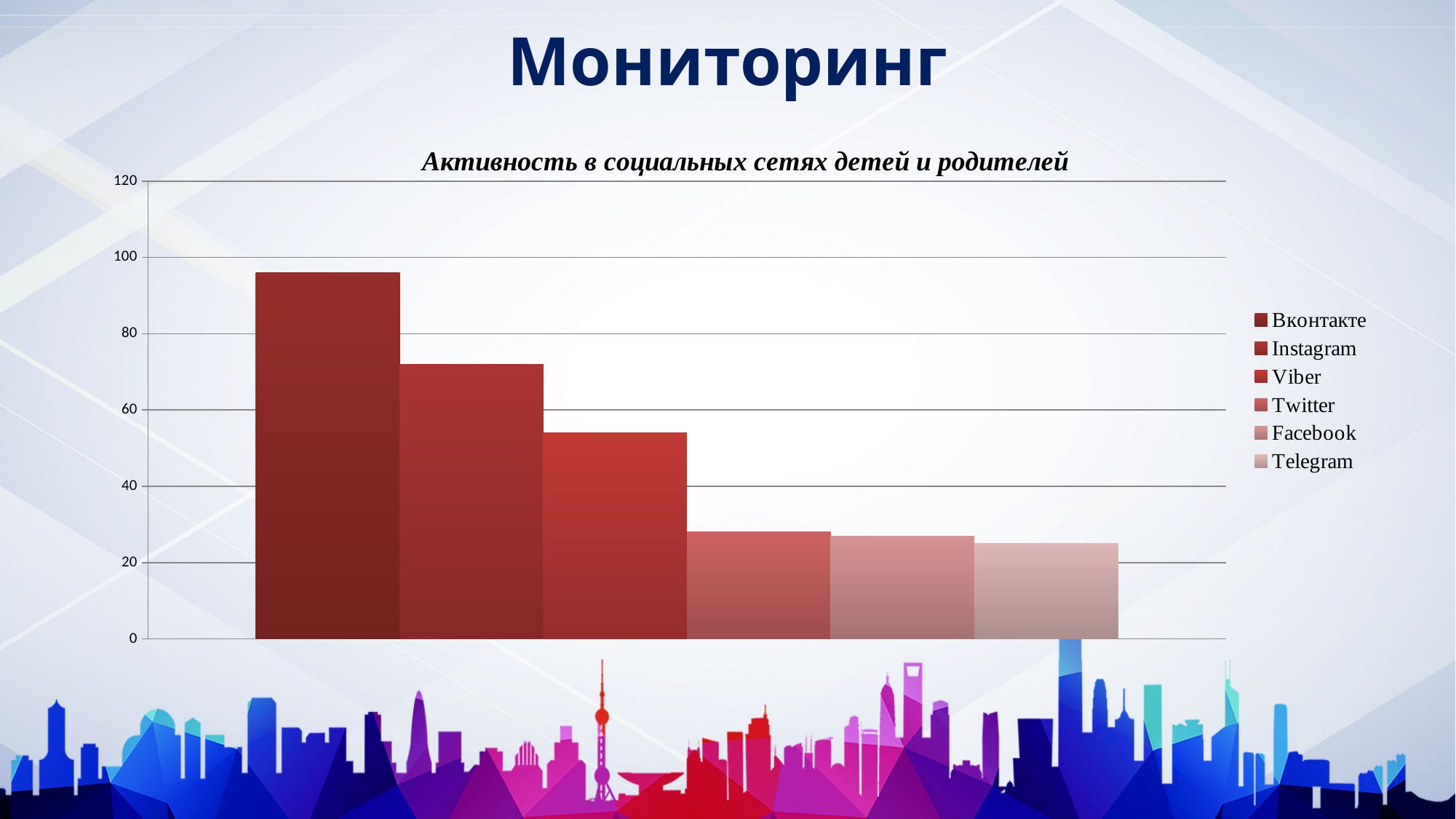
Which social network has the highest value in the chart? Вконтакте Is the value for Twitter greater or less than 40? less Do the bar values rise or fall from left to right across the chart? fall Is the value for Telegram greater or less than 20? greater What is the title of the chart? Активность в социальных сетях детей и родителей Is the value for Instagram greater or less than 60? greater How many series does the legend list? 6 What kind of chart is shown on the slide? bar chart Which is larger, the value for Instagram or the value for Viber? Instagram How many bars are plotted in the chart? 6